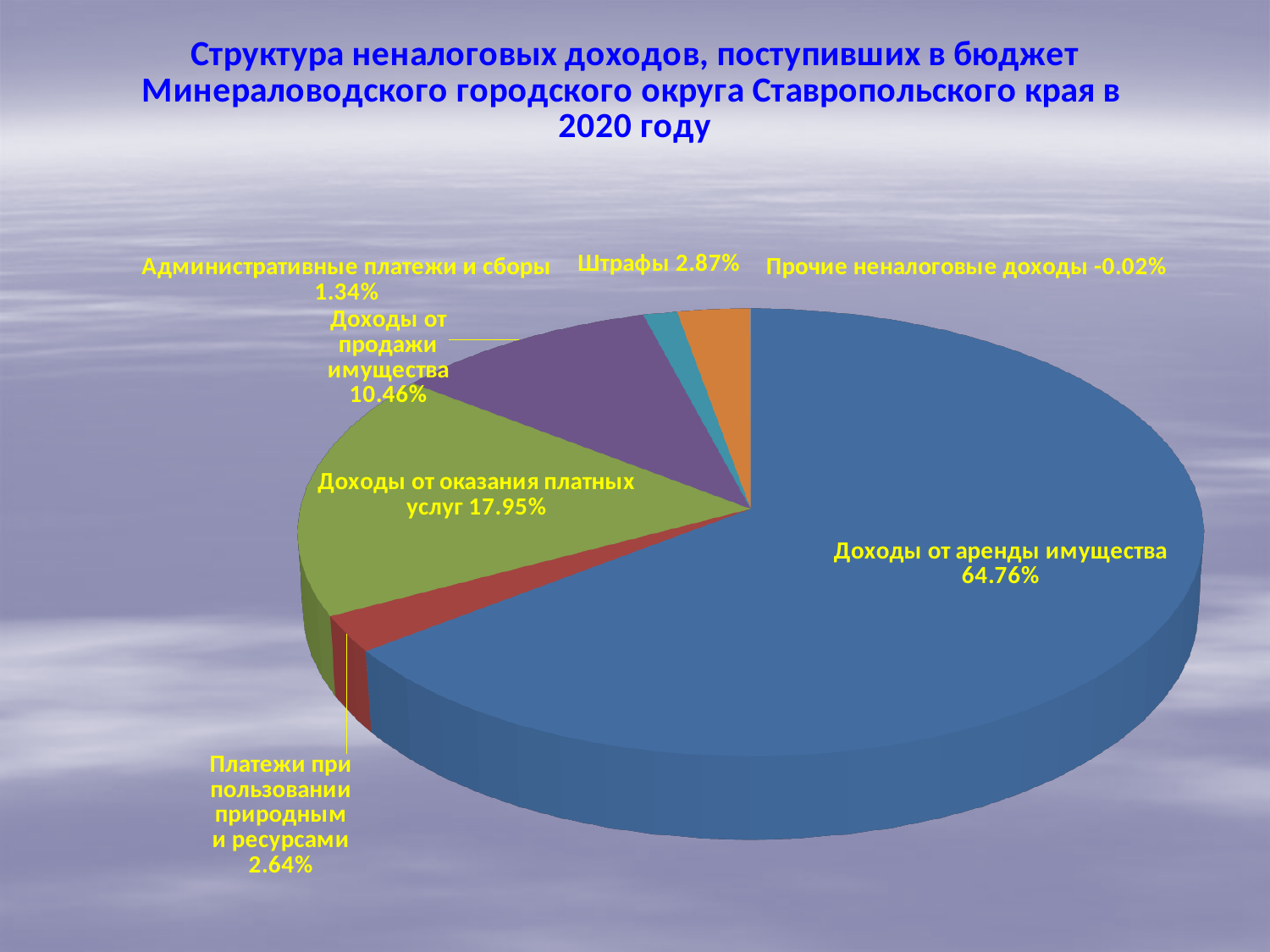
Which category has the largest slice of the pie? Доходы от аренды имущества What percentage is given for Административные платежи и сборы? 1.34% What is the difference between Доходы от оказания платных услуг and Доходы от продажи имущества? 7.49% Is the share for Доходы от аренды имущества greater or less than 50%? greater What type of chart is shown on the slide? Pie chart How many categories are shown in the pie chart? 7 What share is shown for Платежи при пользовании природными ресурсами? 2.64% What percentage is shown for Доходы от оказания платных услуг? 17.95% Which is larger, Штрафы or Платежи при пользовании природными ресурсами? Штрафы What share of the pie does Доходы от аренды имущества have? 64.76% What is the difference between the shares of Доходы от аренды имущества and Доходы от оказания платных услуг? 46.81% What is the value labelled for Штрафы? 2.87%